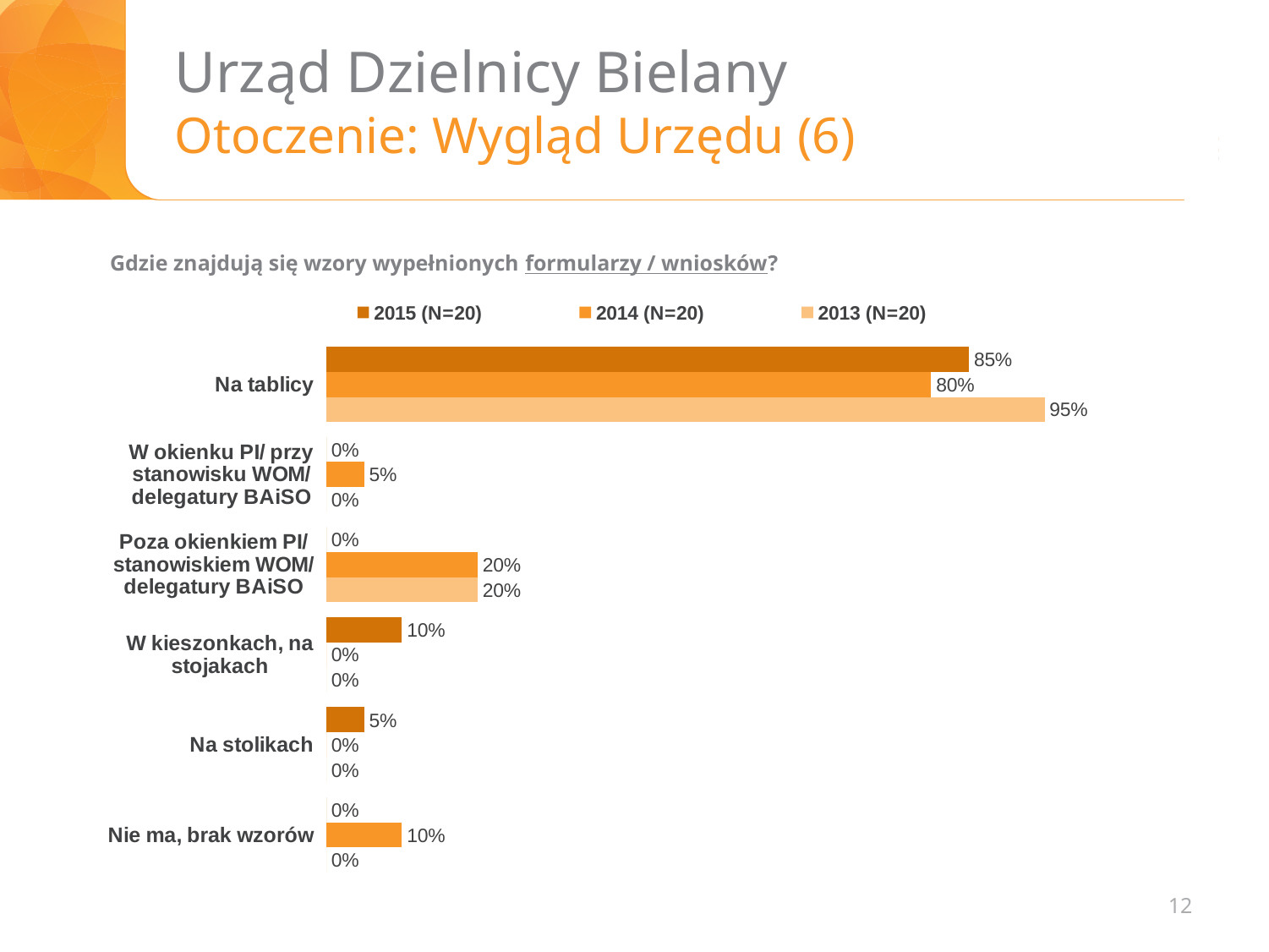
For "Na tablicy", which series has the larger value: 2015 (N=20) or 2014 (N=20)? 2015 (N=20) What question does the chart answer, according to the text above it? Gdzie znajdują się wzory wypełnionych formularzy / wniosków? What is the value for "Nie ma, brak wzorów" in the 2014 (N=20) series? 10% What is the value for "Na tablicy" in the 2013 (N=20) series? 95% What is the value for "Na tablicy" in the 2015 (N=20) series? 85% What is the difference between the 2013 (N=20) and 2014 (N=20) values for "Na tablicy"? 15% How many categories are shown on the chart? 6 What kind of chart is shown on the slide? Bar chart Which category has the highest value in the 2013 (N=20) series? Na tablicy What is the value for "Na stolikach" in the 2015 (N=20) series? 5% What is the value for "W kieszonkach, na stojakach" in the 2015 (N=20) series? 10% How many series does the legend list? 3